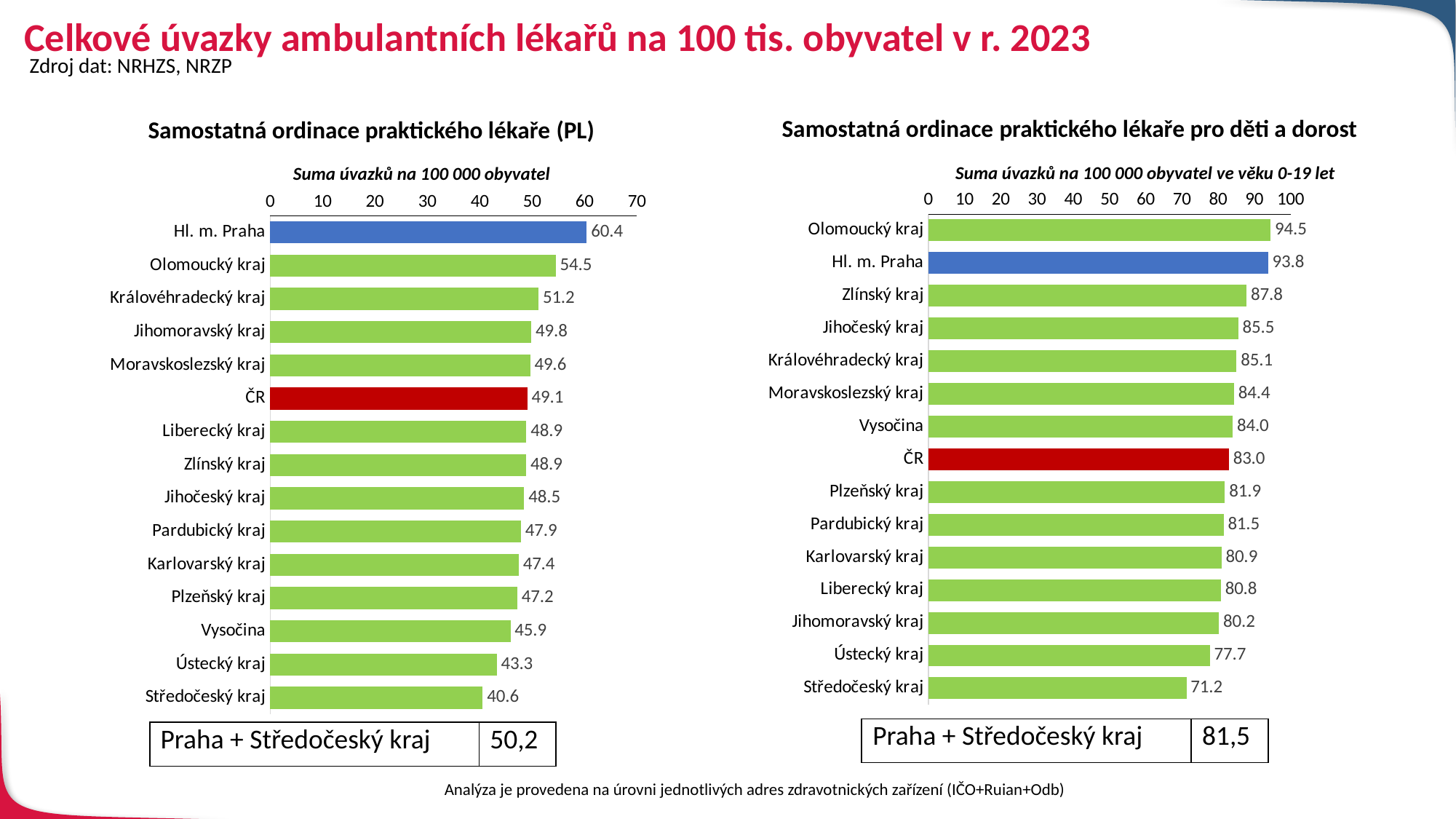
In the chart 'Samostatná ordinace praktického lékaře pro děti a dorost', which category has the highest value? Olomoucký kraj In the chart 'Samostatná ordinace praktického lékaře pro děti a dorost', what is the value for Středočeský kraj? 71.2 In the chart 'Samostatná ordinace praktického lékaře pro děti a dorost', which is larger: Zlínský kraj or Jihočeský kraj? Zlínský kraj In the chart 'Samostatná ordinace praktického lékaře pro děti a dorost', what is the difference between Olomoucký kraj and ČR? 11.5 In the chart 'Samostatná ordinace praktického lékaře (PL)', what is the value for ČR? 49.1 In the chart 'Samostatná ordinace praktického lékaře pro děti a dorost', what colour is the bar for ČR? red In the chart 'Samostatná ordinace praktického lékaře (PL)', what is the value for Hl. m. Praha? 60.4 In the chart 'Samostatná ordinace praktického lékaře (PL)', what is the difference between Hl. m. Praha and Středočeský kraj? 19.8 In the chart 'Samostatná ordinace praktického lékaře pro děti a dorost', is the value for Ústecký kraj greater or less than 80? less In the chart 'Samostatná ordinace praktického lékaře (PL)', which category has the lowest value? Středočeský kraj In the chart 'Samostatná ordinace praktického lékaře (PL)', how many bars are plotted? 15 What kind of chart is 'Samostatná ordinace praktického lékaře (PL)'? bar chart